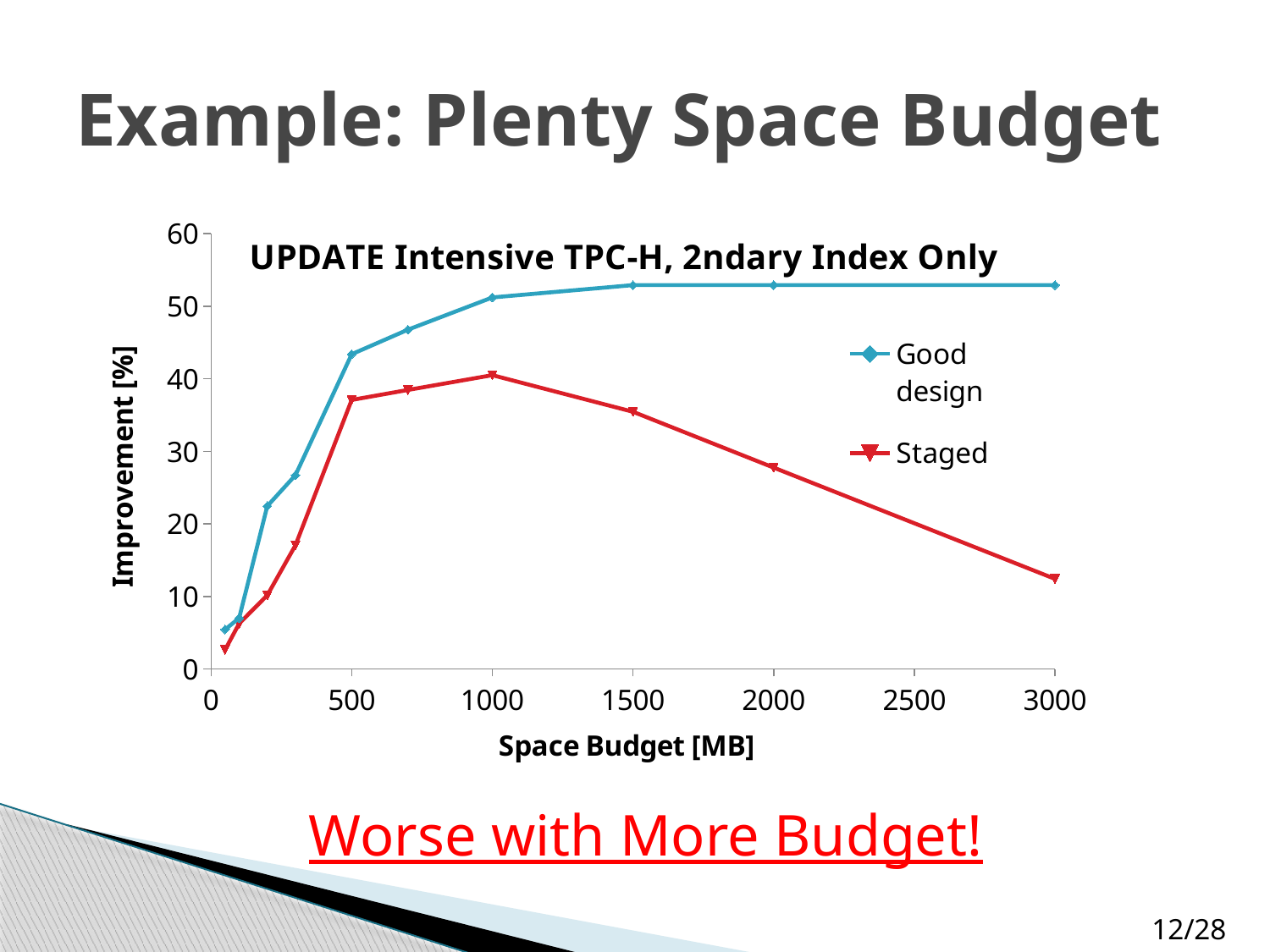
Does the Staged series rise or fall as the space budget increases from 1000 MB to 3000 MB? fall Is the value for Good design at a space budget of 3000 MB greater or less than 50? greater Is the value for Good design at a space budget of 500 MB greater or less than 40? greater At a space budget of 1000 MB, which series has the higher improvement, Good design or Staged? Good design What is the label of the y axis? Improvement [%] At a space budget of 3000 MB, which series has the higher improvement, Good design or Staged? Good design Is the value for Staged at a space budget of 3000 MB greater or less than 20? less What kind of chart is shown on the slide? line chart What is the title of the chart? UPDATE Intensive TPC-H, 2ndary Index Only How many series does the legend list? 2 At which space budget does the Staged series reach its highest improvement? 1000